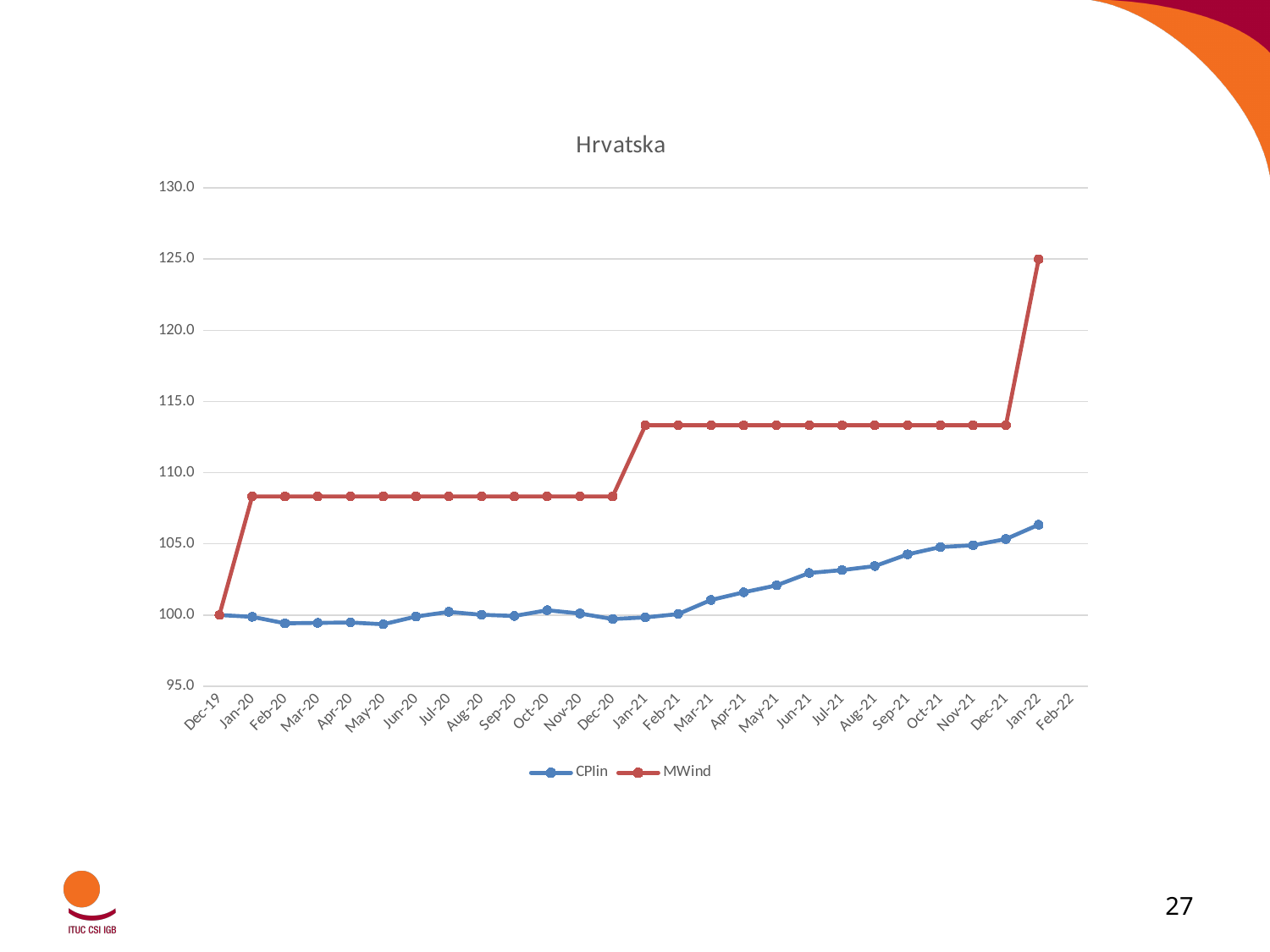
What are the two series named in the legend? CPIin and MWind In Jan-22, which series has the higher value, CPIin or MWind? MWind How many series does the legend list? 2 In which month does MWind reach its highest value? Jan-22 Is the value for MWind in Jun-20 greater or less than 110.0? less Is the value for MWind in Jan-22 greater or less than 120.0? greater What is the value of MWind in Dec-19? 100.0 What type of chart is shown on the slide? line chart What is the value of CPIin in Dec-19? 100.0 Is the value for MWind in Jun-21 greater or less than 110.0? greater What is the title of the chart? Hrvatska